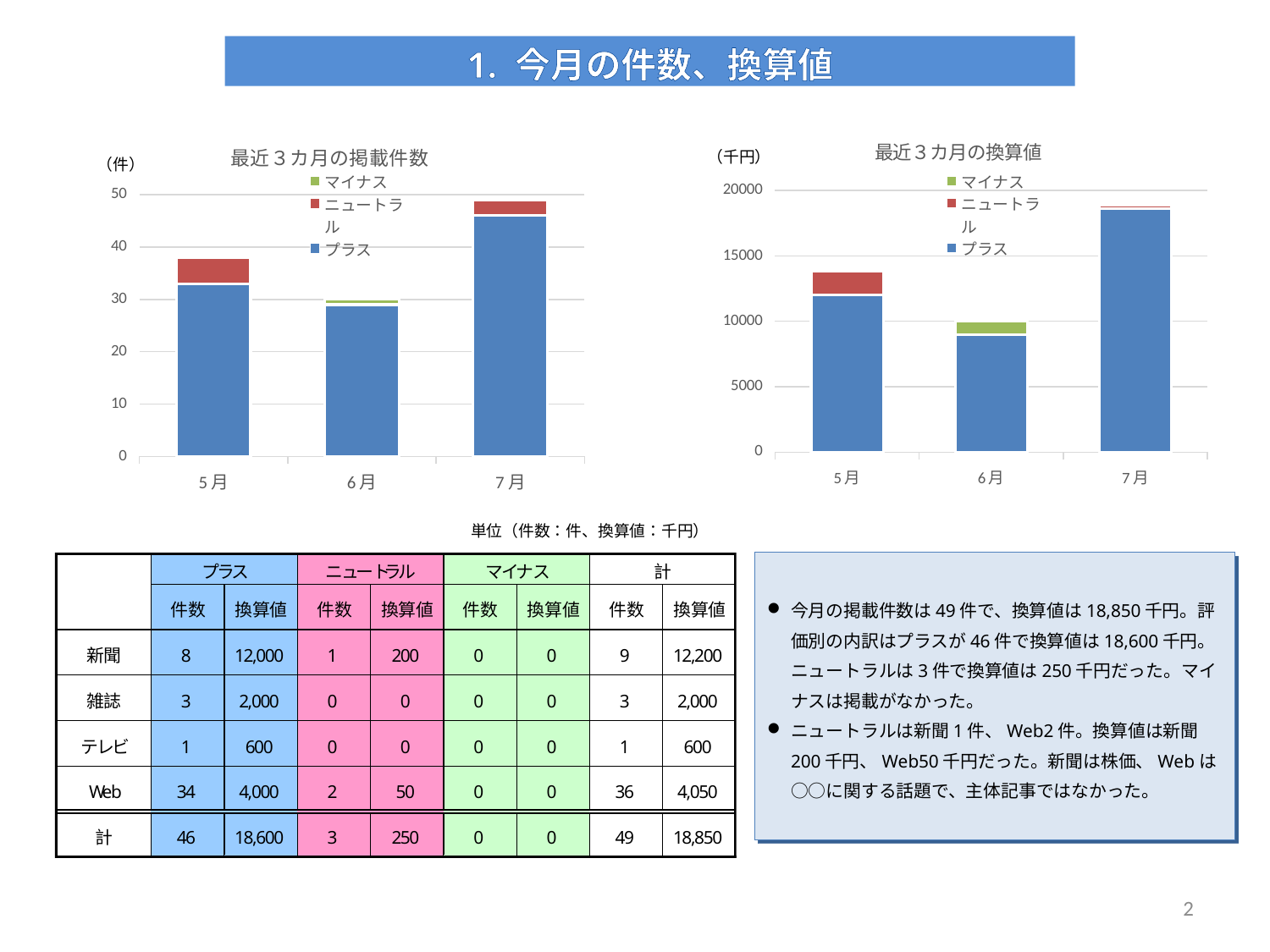
In the left chart (最近３カ月の掲載件数), is the total bar for 5月 greater or less than 30? greater In the right chart (最近３カ月の換算値), which month has the shortest bar? 6月 In the right chart (最近３カ月の換算値), is the total bar for 7月 greater or less than 15000? greater In the left chart (最近３カ月の掲載件数), which month has the shortest bar? 6月 In the left chart (最近３カ月の掲載件数), which month has the tallest bar? 7月 What kind of chart is the left chart titled 最近３カ月の掲載件数? stacked bar chart In the left chart (最近３カ月の掲載件数), is the total bar for 7月 greater or less than 40? greater In the left chart (最近３カ月の掲載件数), how many months are shown on the x axis? 3 In the left chart (最近３カ月の掲載件数), how many series does the legend list? 3 In the right chart (最近３カ月の換算値), what unit is shown above the vertical axis? 千円 In the right chart (最近３カ月の換算値), which month has the tallest bar? 7月